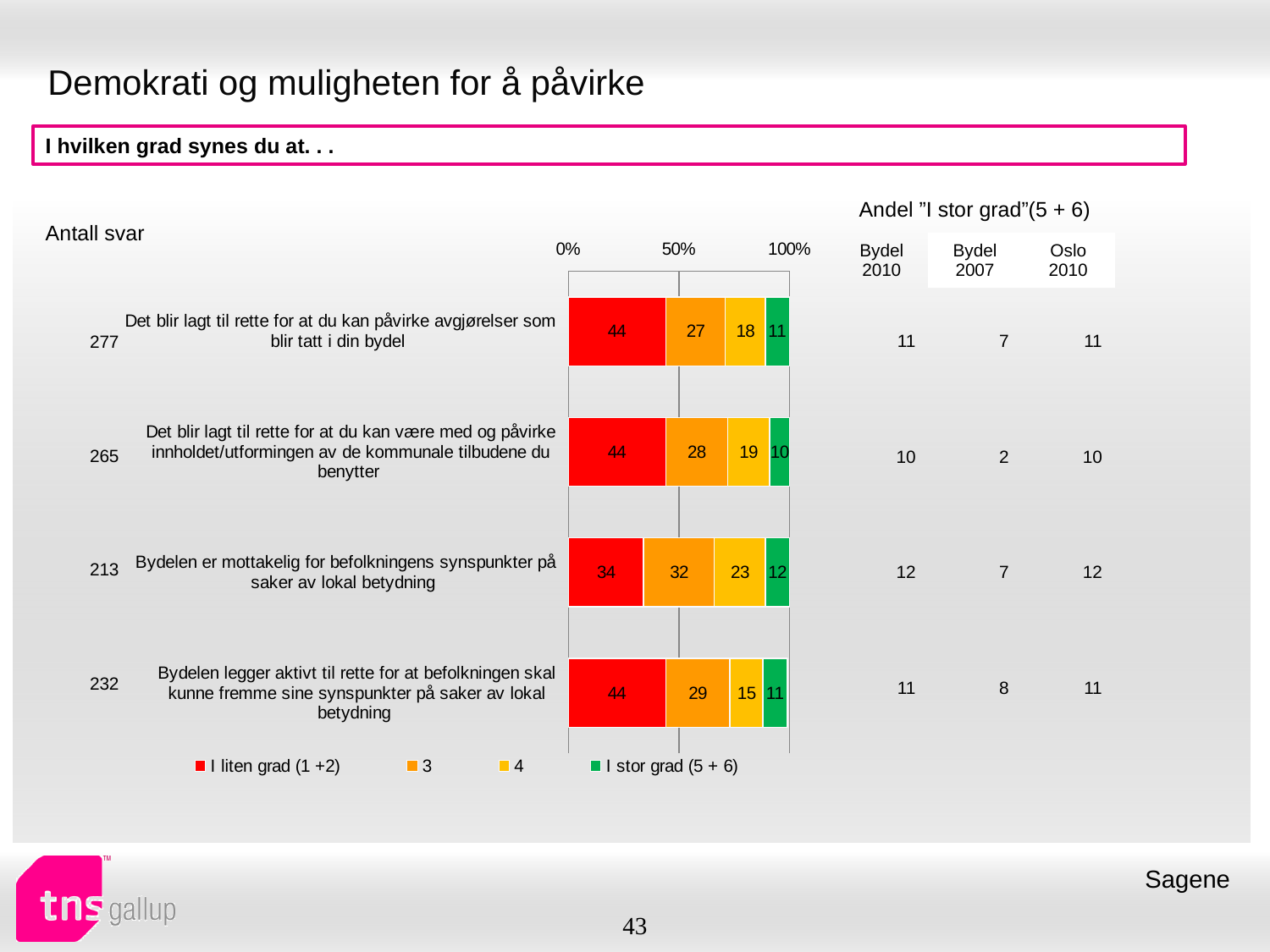
What type of chart is shown on the slide? stacked bar chart Which is larger for "Bydelen er mottakelig for befolkningens synspunkter på saker av lokal betydning": the value for series "3" or the value for series "4"? 3 Which statement has the lowest value for "I liten grad (1 +2)"? Bydelen er mottakelig for befolkningens synspunkter på saker av lokal betydning What is the value of "I liten grad (1 +2)" for "Bydelen er mottakelig for befolkningens synspunkter på saker av lokal betydning"? 34 How many series does the chart legend list? 4 What is the value of series "3" for "Det blir lagt til rette for at du kan påvirke avgjørelser som blir tatt i din bydel"? 27 Which statement has the highest value for series "4"? Bydelen er mottakelig for befolkningens synspunkter på saker av lokal betydning What is the value of "I stor grad (5 + 6)" for "Det blir lagt til rette for at du kan være med og påvirke innholdet/utformingen av de kommunale tilbudene du benytter"? 10 What is the difference between the "I liten grad (1 +2)" value and the "I stor grad (5 + 6)" value for "Det blir lagt til rette for at du kan påvirke avgjørelser som blir tatt i din bydel"? 33 What is the total of the stacked bar for "Bydelen legger aktivt til rette for at befolkningen skal kunne fremme sine synspunkter på saker av lokal betydning"? 99 How many categories (statements) are plotted in the chart? 4 What is the value of series "4" for "Bydelen legger aktivt til rette for at befolkningen skal kunne fremme sine synspunkter på saker av lokal betydning"? 15